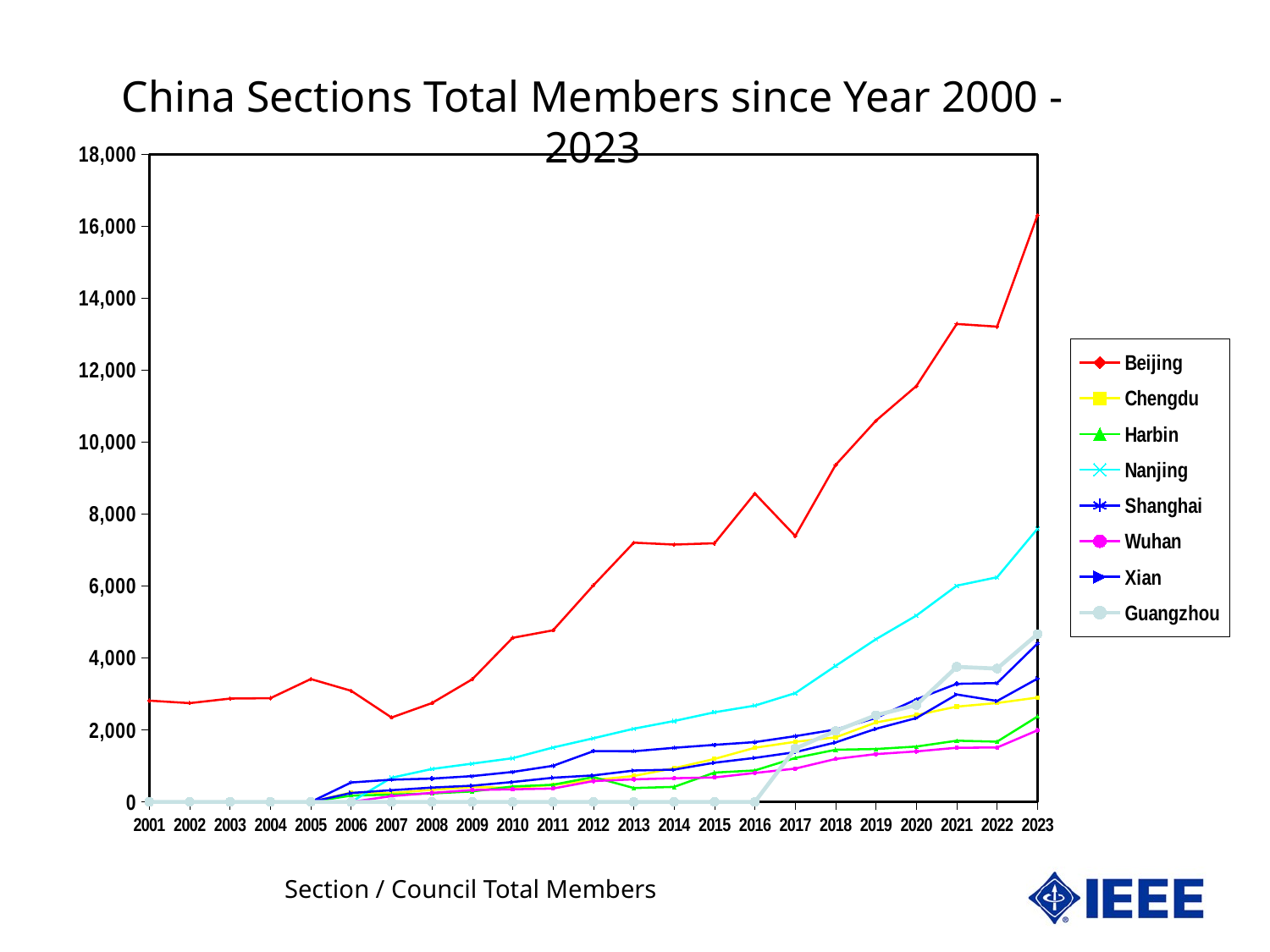
Which is larger in 2023, the value for Nanjing or the value for Xian? Nanjing Which section has the second highest total members in 2023? Nanjing Which section has the highest total members in 2023? Beijing What colour is the Beijing line in the legend? red How many years are shown along the x axis? 23 How many series does the legend list? 8 Is the value for Beijing in 2023 greater or less than 14,000? greater Does the Beijing line generally rise or fall from 2001 to 2023? rise What kind of chart is shown on the slide? line chart Is the value for Nanjing in 2023 greater or less than 6,000? greater Is the value for Beijing in 2017 greater or less than 8,000? less What is the value for Guangzhou in 2010? 0